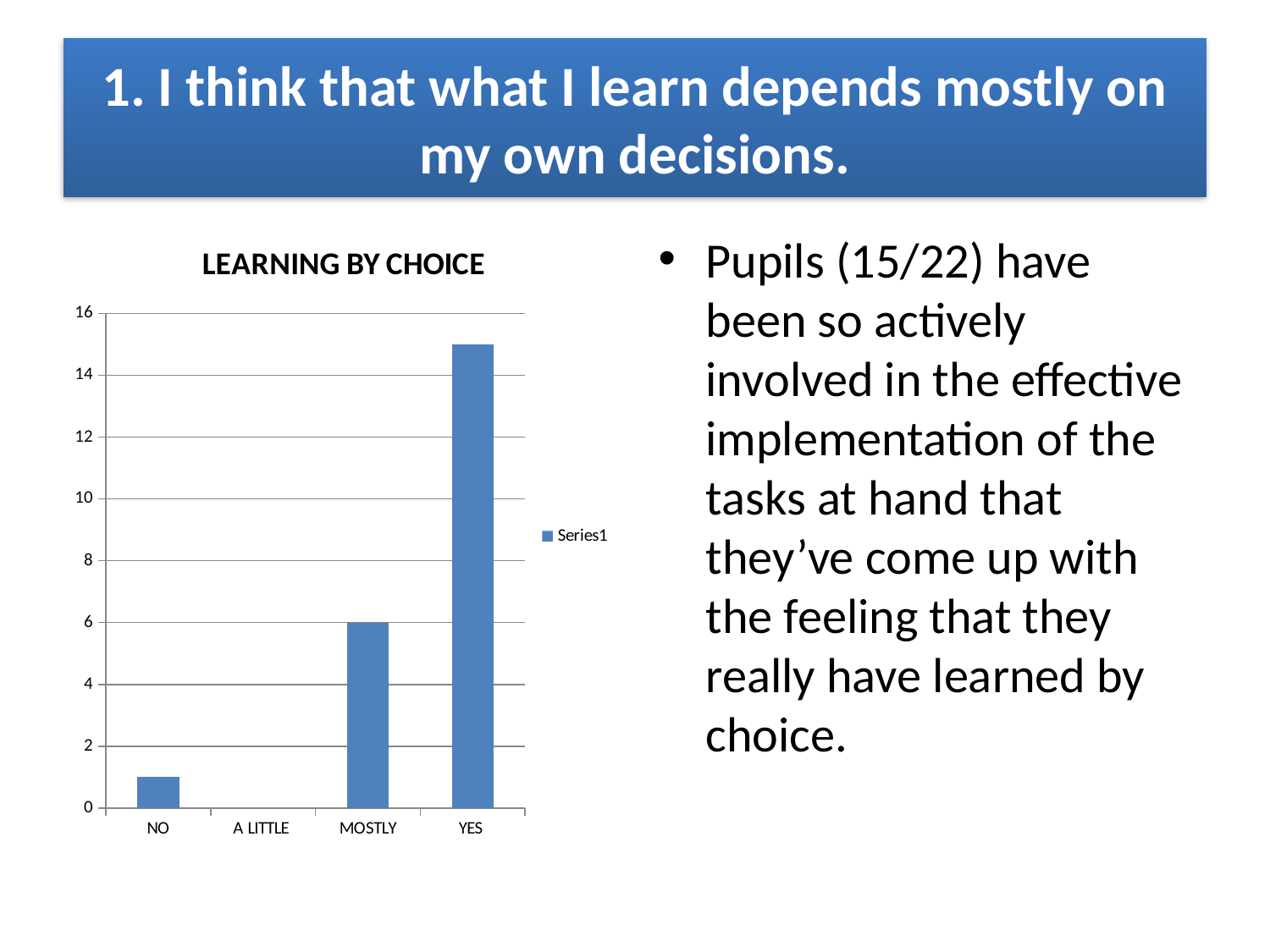
What is the name of the series shown in the legend? Series1 What is the title of the chart? LEARNING BY CHOICE What type of chart is shown on the slide? bar chart Which category has the lowest value in the chart? A LITTLE Which is larger, the value for MOSTLY or the value for YES? YES Which category has the highest value in the chart? YES How many series does the chart legend list? 1 Which is larger, the value for NO or the value for MOSTLY? MOSTLY How many categories are shown on the x axis of the chart? 4 Is the value for NO greater or less than 2? less What is the value for MOSTLY? 6 Is the value for YES greater or less than 14? greater